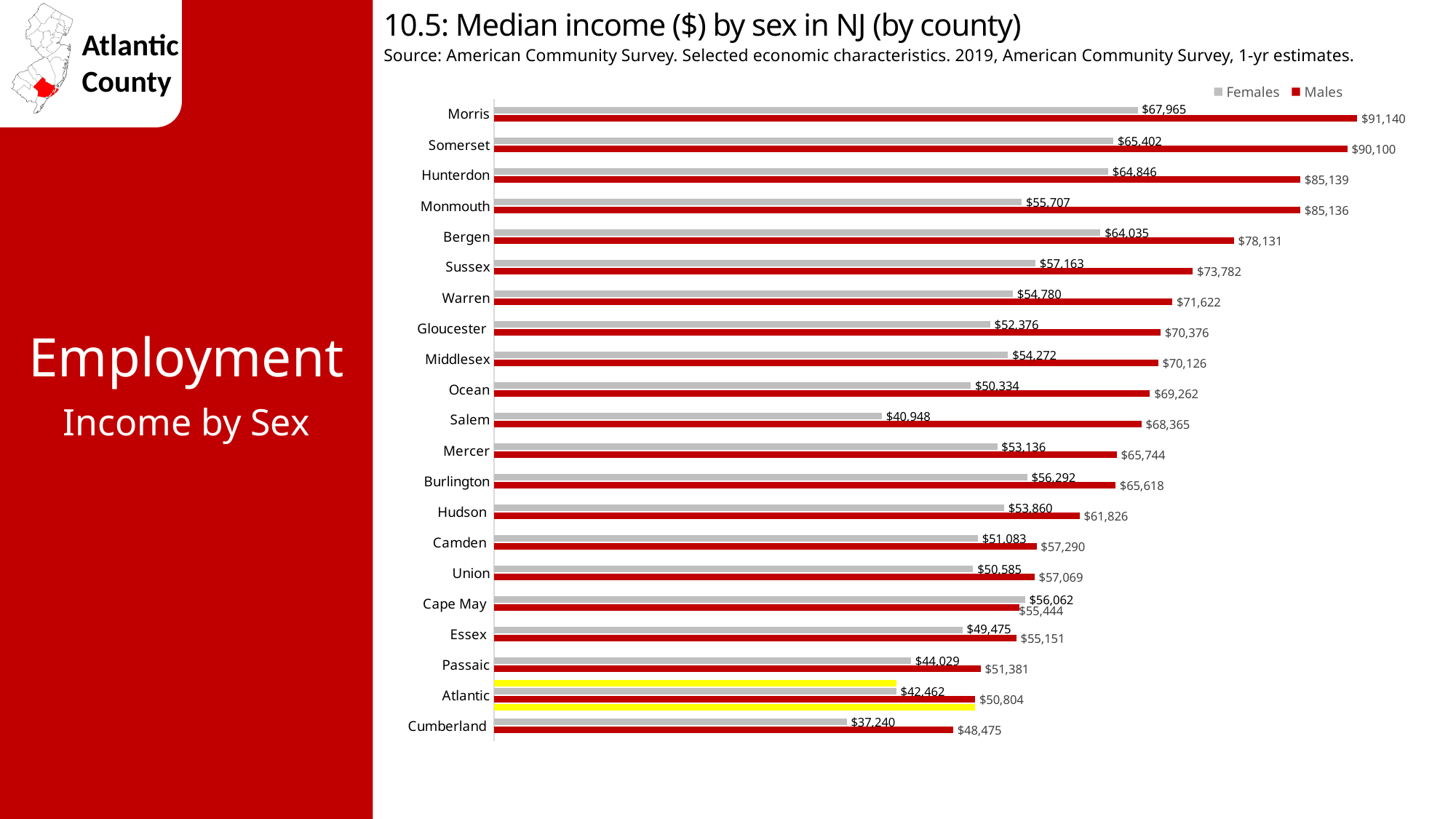
How many counties are shown in the chart? 21 What is the difference between male and female median income in Atlantic County? $8,342 Which county has the highest median income for males? Morris In Cape May County, is the median income higher for females or for males? Females What is the median income for females in Salem County? $40,948 What is the median income for females in Atlantic County? $42,462 What kind of chart is shown on the slide? Bar chart How many series does the legend list? 2 What is the difference between male and female median income in Morris County? $23,175 Which county has the lowest median income for females? Cumberland What is the median income for males in Atlantic County? $50,804 Which colour represents the Males series in the chart? Red